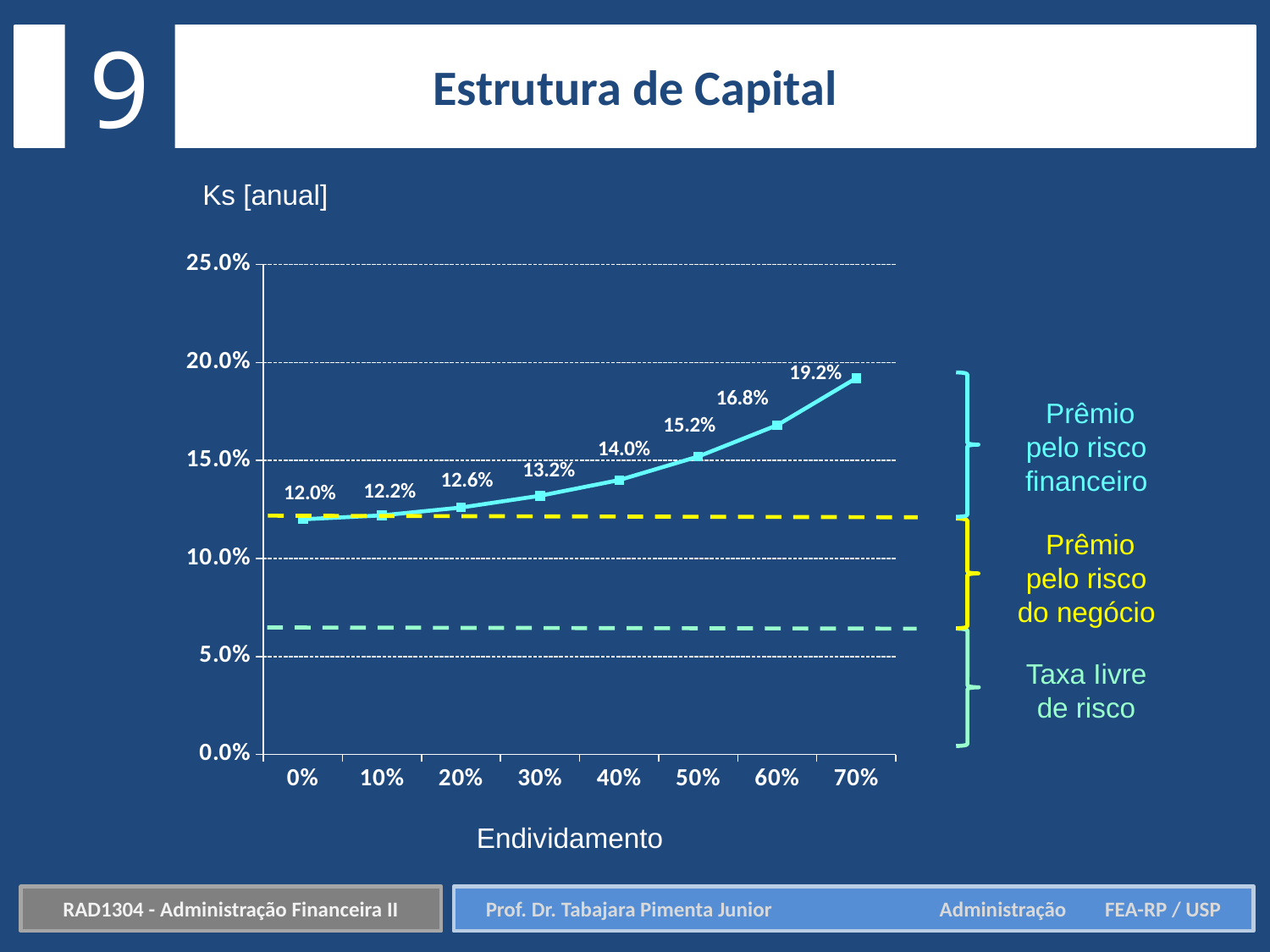
Does Ks rise or fall as Endividamento increases? rise At which level of Endividamento is Ks lowest? 0% At which level of Endividamento is Ks highest? 70% What is the value of Ks at 40% Endividamento? 14.0% What is the value of Ks at 60% Endividamento? 16.8% What is the difference between Ks at 70% and Ks at 0% Endividamento? 7.2% What kind of chart is shown on the slide? line chart What is the value of Ks at 0% Endividamento? 12.0% Which is larger, Ks at 30% or Ks at 50% Endividamento? 50% How many data points are plotted on the Ks line? 8 Is the value of Ks at 70% Endividamento greater or less than 20.0%? less What is the label of the x axis? Endividamento